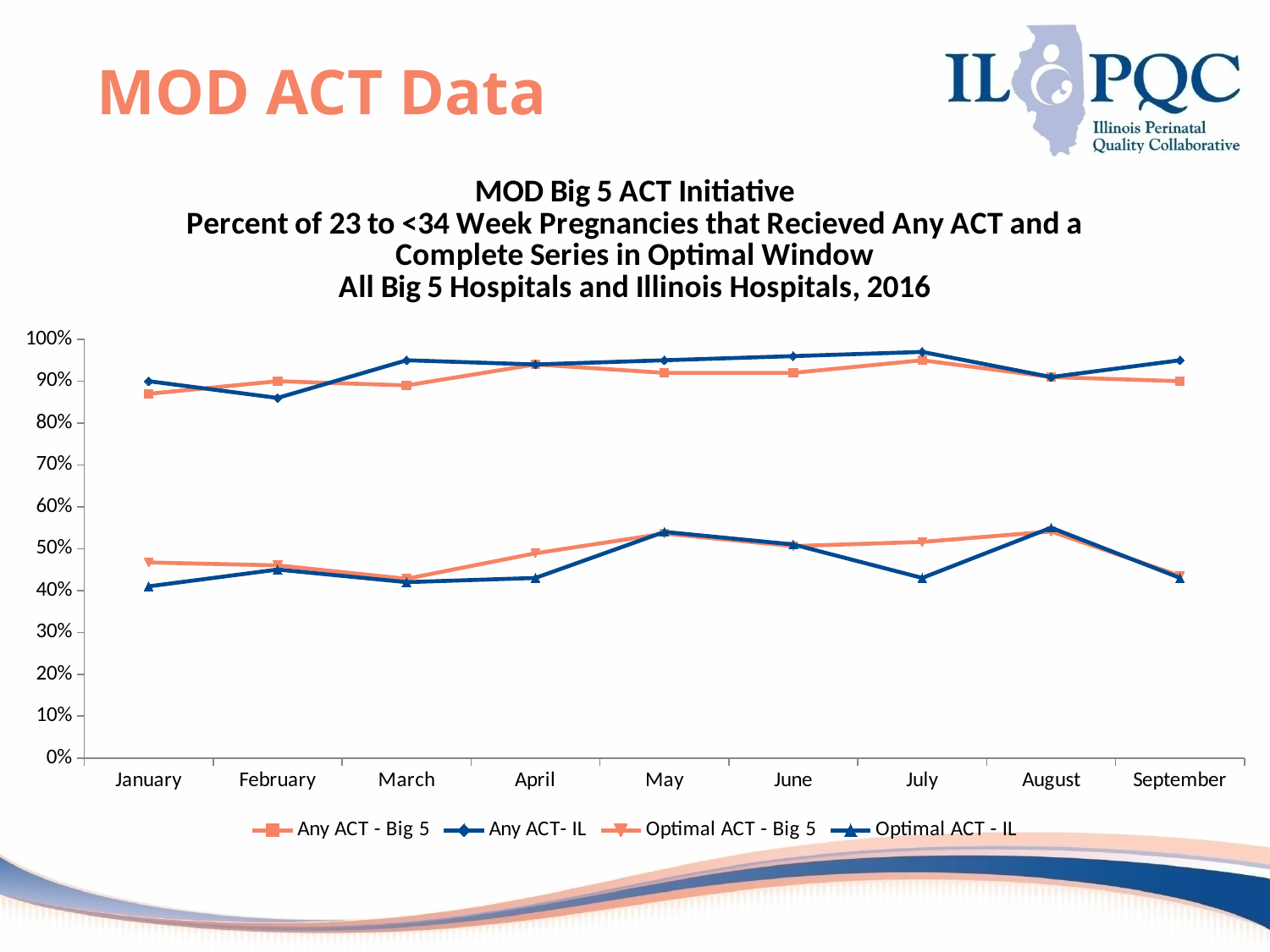
Which year of data does the chart title say it covers? 2016 In which month is the Any ACT- IL series at its lowest? February Which two series are drawn in dark blue according to the legend? Any ACT- IL and Optimal ACT - IL How many series does the legend list? 4 Is the value for Optimal ACT - IL in January greater or less than 50%? less Does the Optimal ACT - IL series rise or fall from July to August? rise In March, which is larger: Any ACT- IL or Any ACT - Big 5? Any ACT- IL What kind of chart is shown on the slide? line chart How many months are shown along the x axis? 9 Is the value for Optimal ACT - Big 5 in May greater or less than 50%? greater In July, which is larger: Optimal ACT - Big 5 or Optimal ACT - IL? Optimal ACT - Big 5 Is the value for Any ACT- IL in July greater or less than 90%? greater